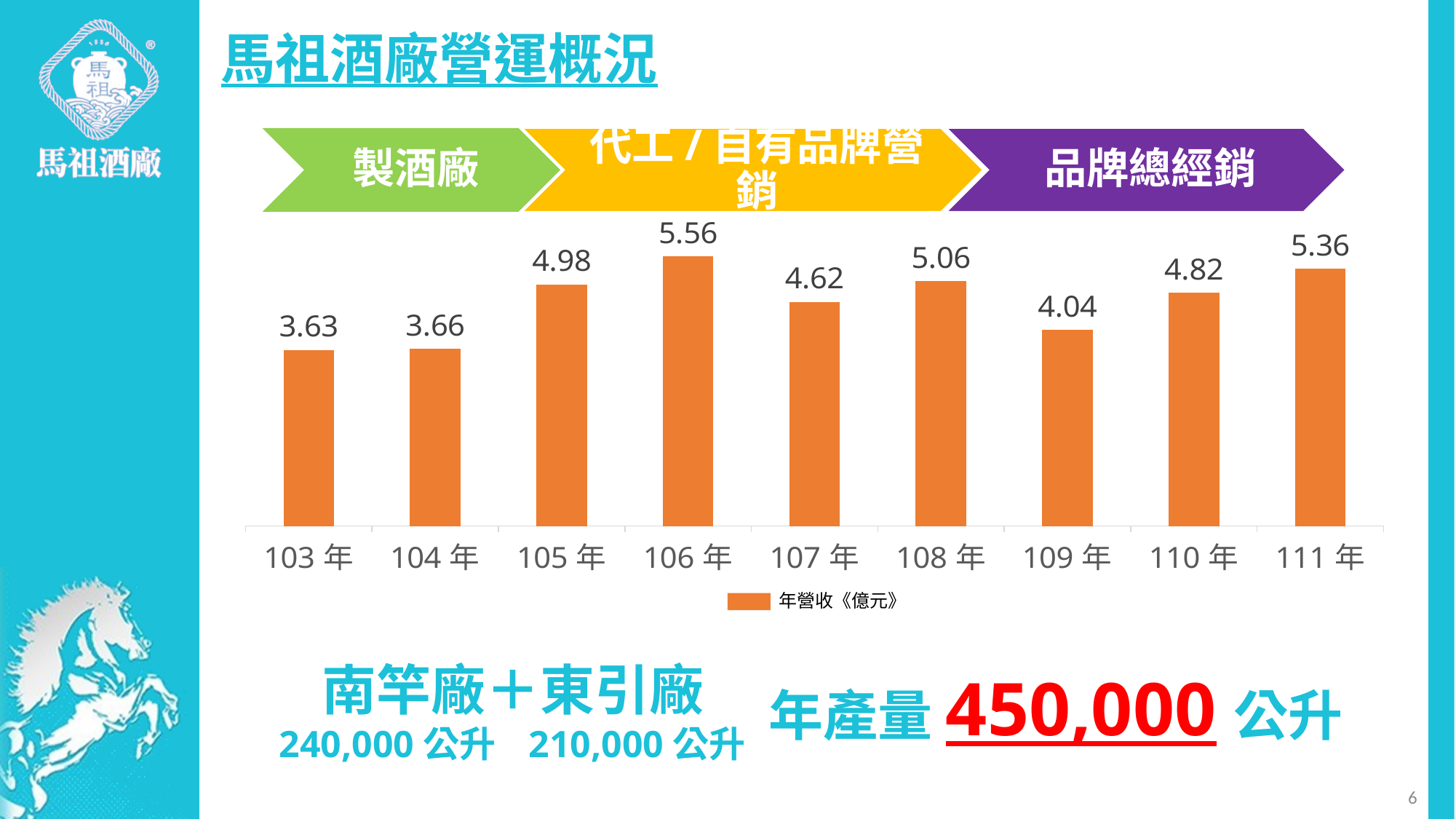
What is the difference in annual revenue between 106 年 and 107 年? 0.94 What is the annual revenue (年營收) for 106 年? 5.56 How many series does the chart legend list? 1 What is the annual revenue (年營收) for 109 年? 4.04 Which year has higher annual revenue, 108 年 or 110 年? 108 年 What kind of chart is shown on the slide? Bar chart How many years are shown on the x axis of the chart? 9 Which year has the lowest annual revenue? 103 年 Which year has the highest annual revenue? 106 年 What is the annual revenue (年營收) for 103 年? 3.63 What is the legend entry for the series in the chart? 年營收《億元》 What is the annual revenue (年營收) for 111 年? 5.36